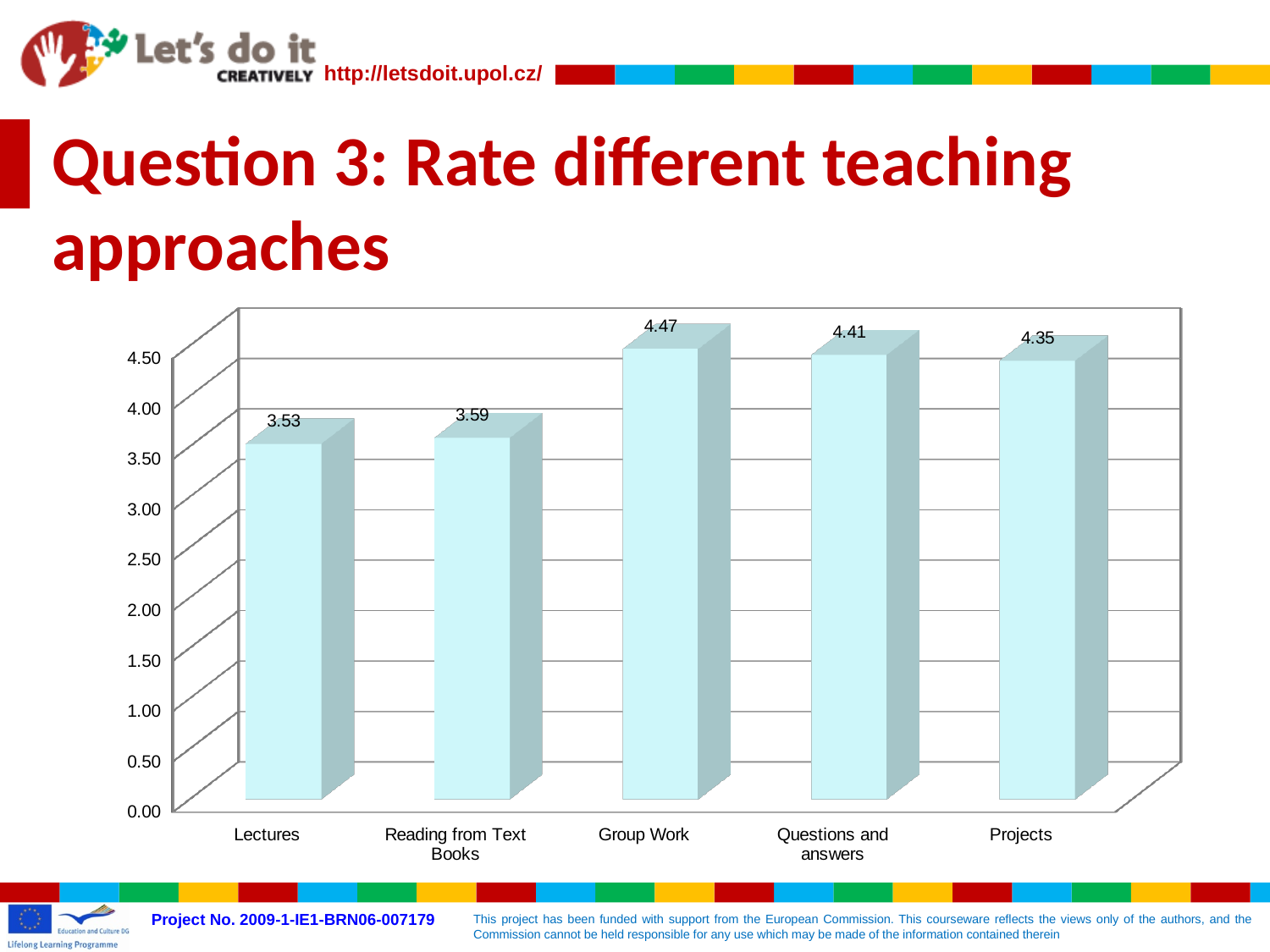
What is the rating for Group Work? 4.47 What kind of chart is shown on the slide? Bar chart Which has a higher rating, Reading from Text Books or Projects? Projects Which teaching approach has the lowest rating? Lectures What is the difference between the ratings for Group Work and Lectures? 0.94 What is the rating for Projects? 4.35 How many teaching approaches are shown on the chart? 5 What is the difference between the ratings for Questions and answers and Projects? 0.06 What is the rating for Lectures? 3.53 What is the rating for Reading from Text Books? 3.59 Is the value for Lectures greater or less than 4.00? less Which teaching approach has the highest rating? Group Work